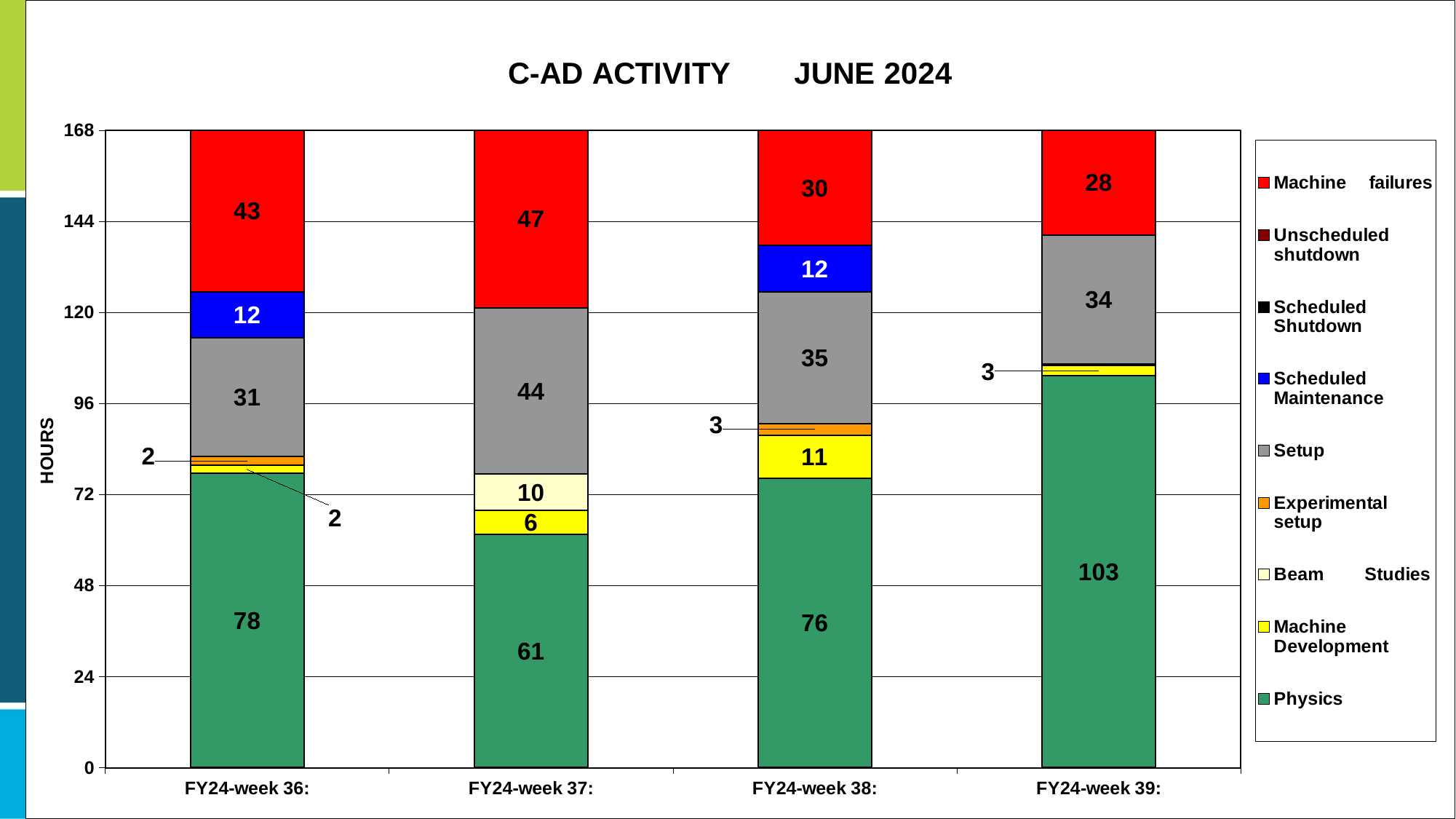
Which week has the highest Physics value? FY24-week 39 What is the difference between the Machine failures values for FY24-week 37 and FY24-week 39? 19 What is the Beam Studies value for FY24-week 37? 10 Which week has the lowest Physics value? FY24-week 37 What is the Machine failures value for FY24-week 37? 47 What kind of chart is shown on the slide? Stacked bar chart What is the total of the stacked bar for FY24-week 37? 168 How many series does the legend list? 9 How many Physics hours are shown for FY24-week 39? 103 Do the Machine failures values rise or fall from FY24-week 37 to FY24-week 39? Fall How many weeks (categories) are plotted along the x axis? 4 Which week has the larger Setup value, FY24-week 37 or FY24-week 38? FY24-week 37